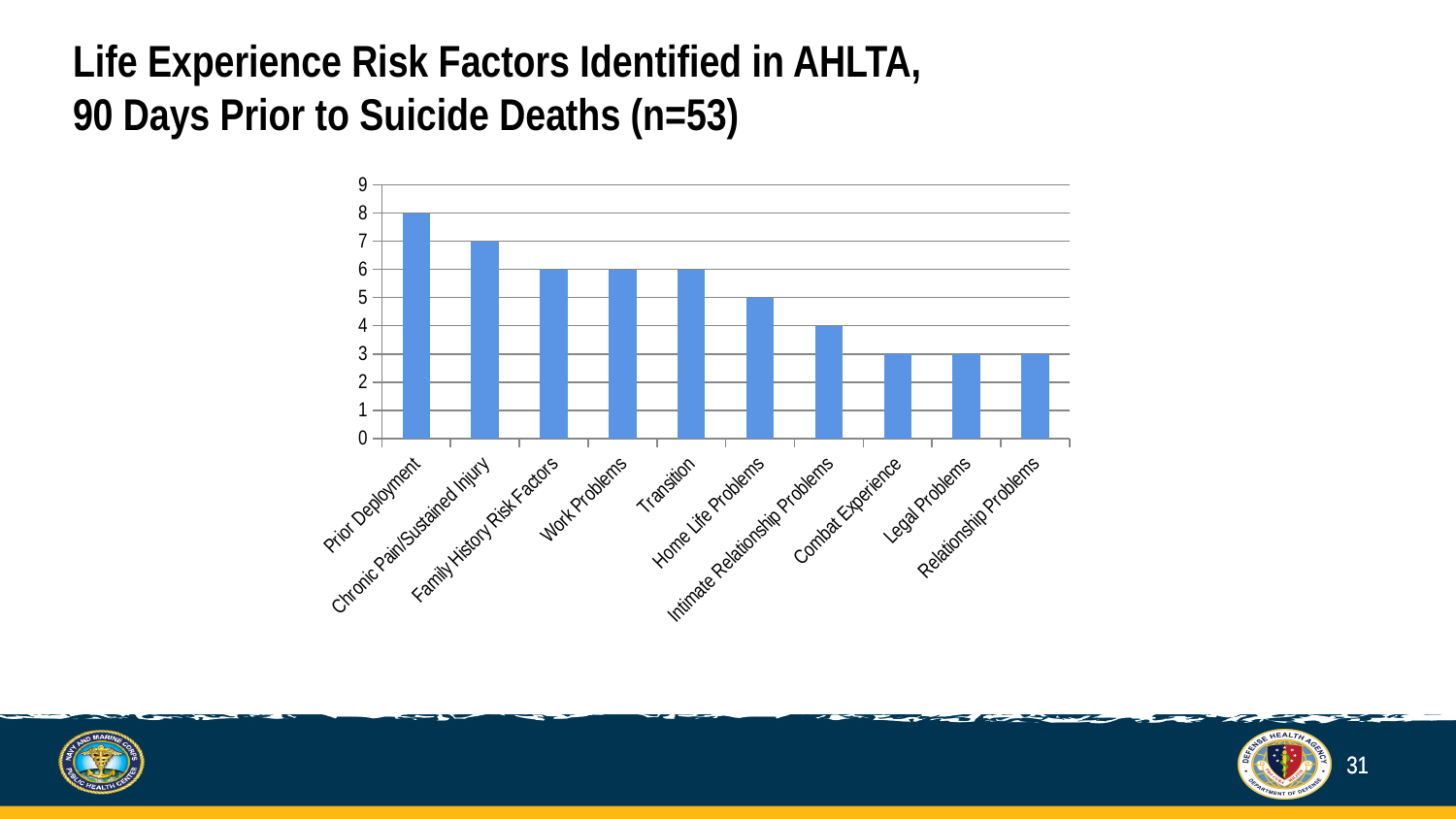
Which category has the highest value? Prior Deployment What kind of chart is shown on the slide? bar chart Which is larger, the value for Transition or the value for Legal Problems? Transition What is the difference between the values for Prior Deployment and Combat Experience? 5 What is the value for Intimate Relationship Problems? 4 Is the value for Work Problems greater or less than 4? greater What is the value for Chronic Pain/Sustained Injury? 7 How many categories are shown on the x axis? 10 Do the values rise or fall moving from left to right along the x axis? fall What is the value for Prior Deployment? 8 What is the value for Home Life Problems? 5 What is the highest value shown on the y axis? 9